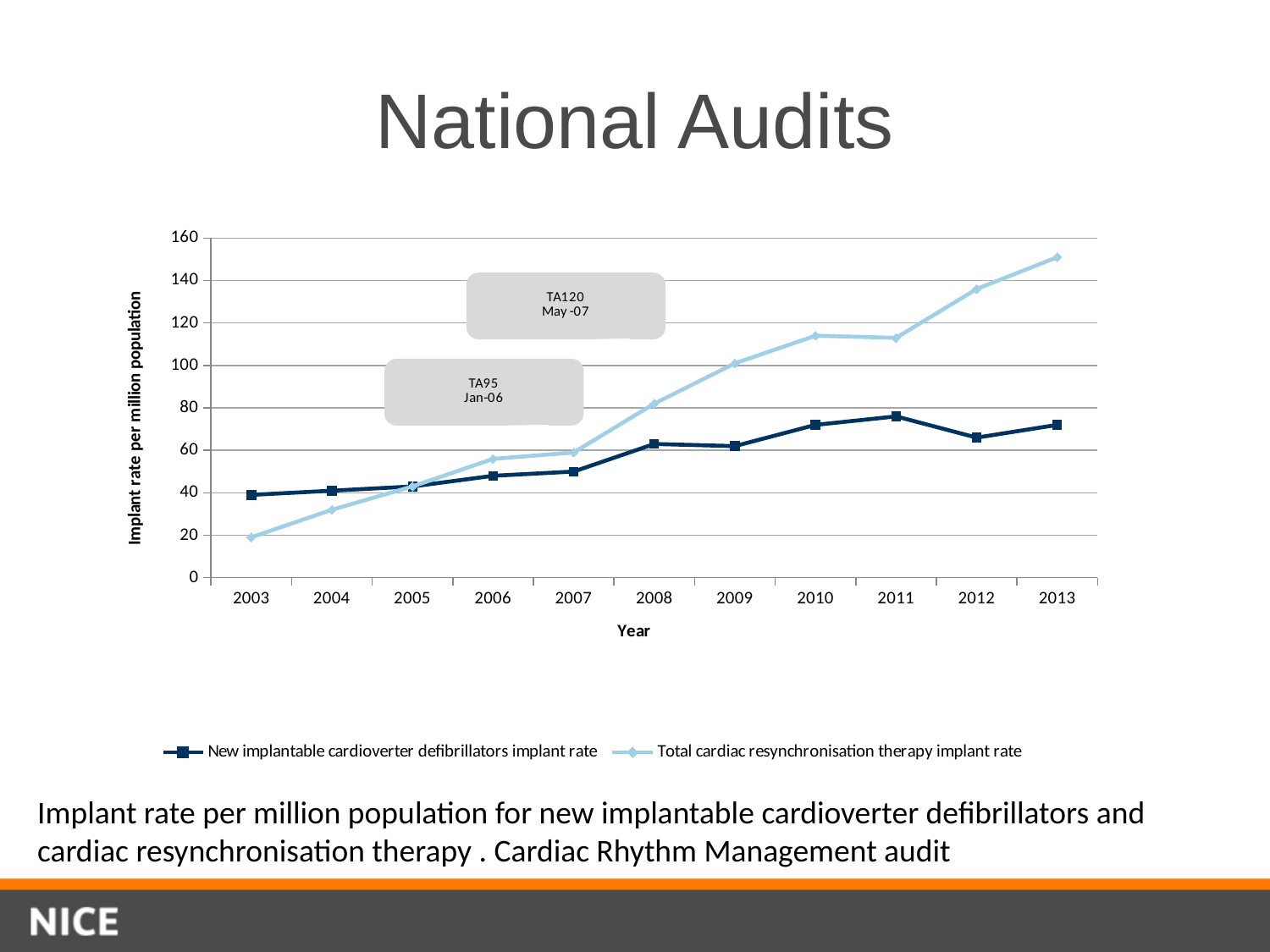
How many series does the legend list? 2 Does the Total cardiac resynchronisation therapy implant rate generally rise or fall from 2003 to 2013? rise Is the Total cardiac resynchronisation therapy implant rate in 2013 greater or less than 140? greater Which year has the highest Total cardiac resynchronisation therapy implant rate? 2013 What is the label on the y axis of the chart? Implant rate per million population What kind of chart is shown on the slide? line chart How many years are plotted along the x axis? 11 In 2003, which series has the larger value: New implantable cardioverter defibrillators implant rate or Total cardiac resynchronisation therapy implant rate? New implantable cardioverter defibrillators implant rate Which year has the lowest Total cardiac resynchronisation therapy implant rate? 2003 Which year has the highest New implantable cardioverter defibrillators implant rate? 2011 Is the New implantable cardioverter defibrillators implant rate in 2011 greater or less than 80? less In 2013, which series has the larger value: New implantable cardioverter defibrillators implant rate or Total cardiac resynchronisation therapy implant rate? Total cardiac resynchronisation therapy implant rate